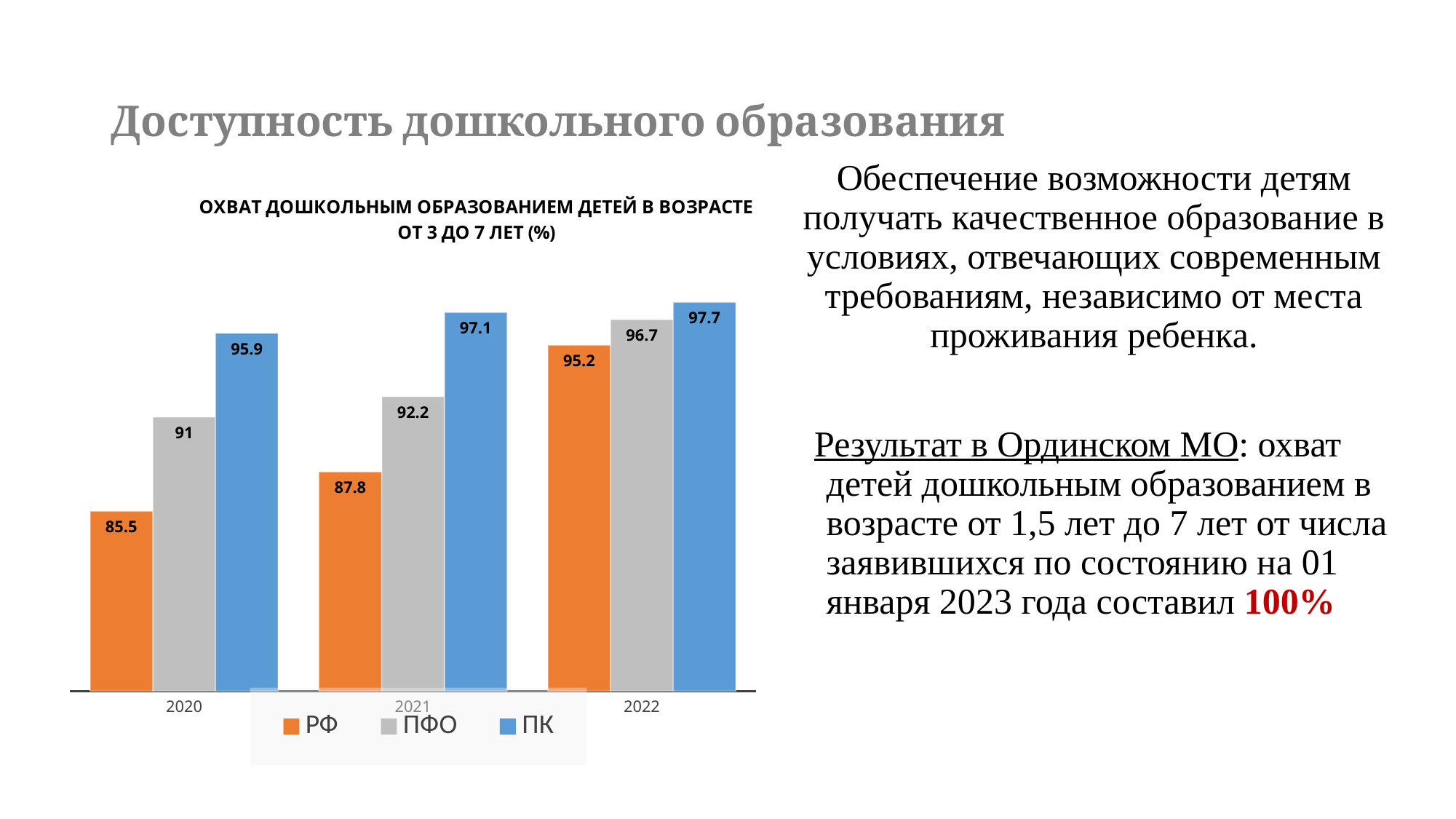
How many series does the legend list? 3 What colour are the ПК bars? Blue Do the РФ values rise or fall from 2020 to 2022? Rise What kind of chart is shown on the slide? Bar chart What is the value for РФ in 2020? 85.5 What is the value for ПК in 2022? 97.7 Which series has the highest value in 2021? ПК Which series has the lowest value in 2022? РФ How many years are shown on the x axis? 3 Which is larger: the ПФО value in 2022 or the ПК value in 2020? ПФО in 2022 What is the value for ПФО in 2021? 92.2 What is the difference between the ПК and РФ values in 2020? 10.4